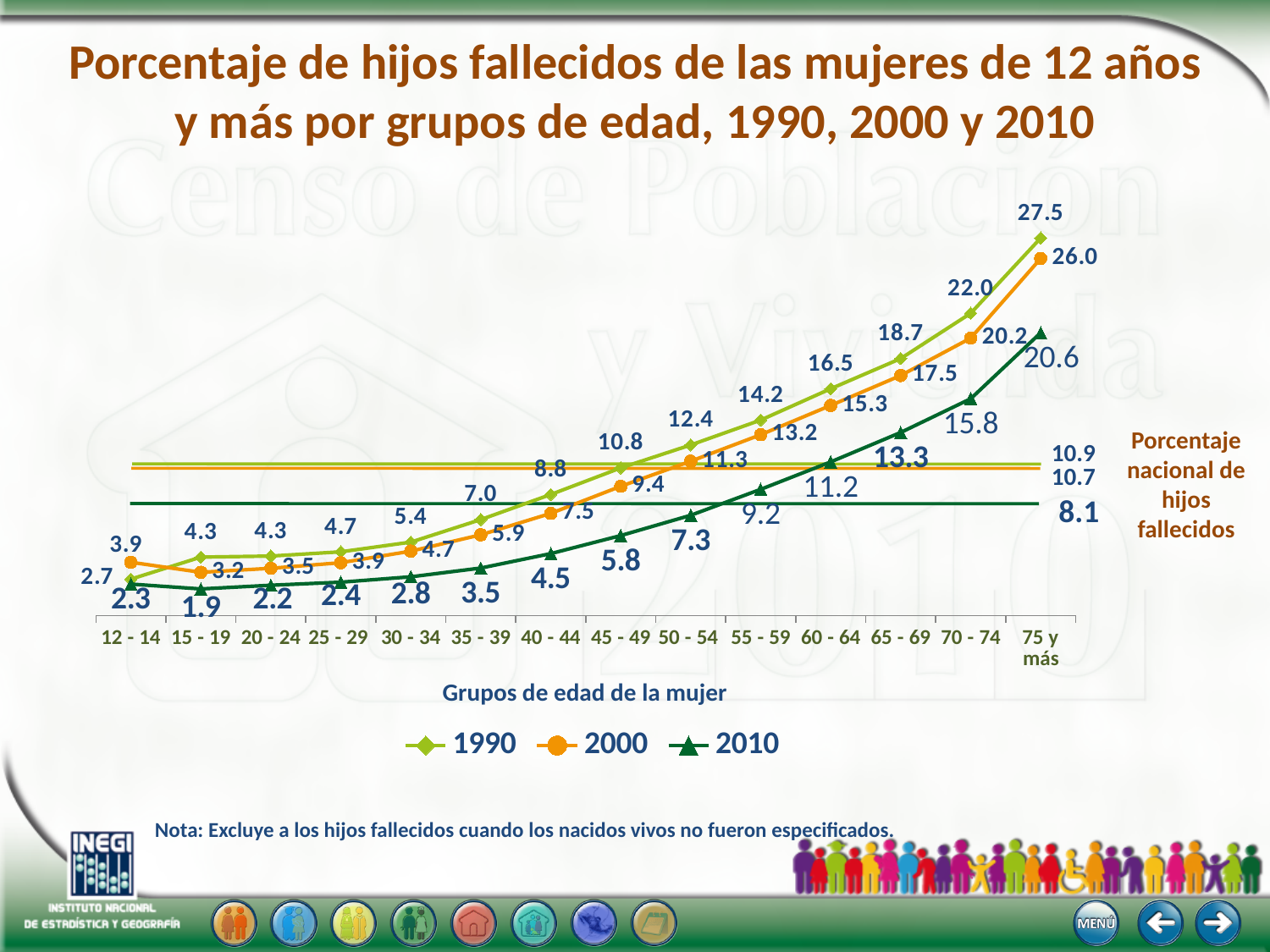
Which age group has the highest value for the 1990 series? 75 y más What is the national percentage of deceased children shown for 2010? 8.1 What is the value for the 1990 series in the 45 - 49 age group? 10.8 How many series does the legend list? 3 How do the values of the 2010 series change from the 15 - 19 age group to the 75 y más age group? they rise What type of chart is shown on the slide? line chart What is the value for the 2010 series in the 75 y más age group? 20.6 What is the value for the 2000 series in the 60 - 64 age group? 15.3 In the 12 - 14 age group, which series has the larger value, 1990 or 2000? 2000 How many age groups are shown on the x axis? 14 What is the difference between the 1990 and 2010 values in the 75 y más age group? 6.9 Which age group has the lowest value for the 2010 series? 15 - 19